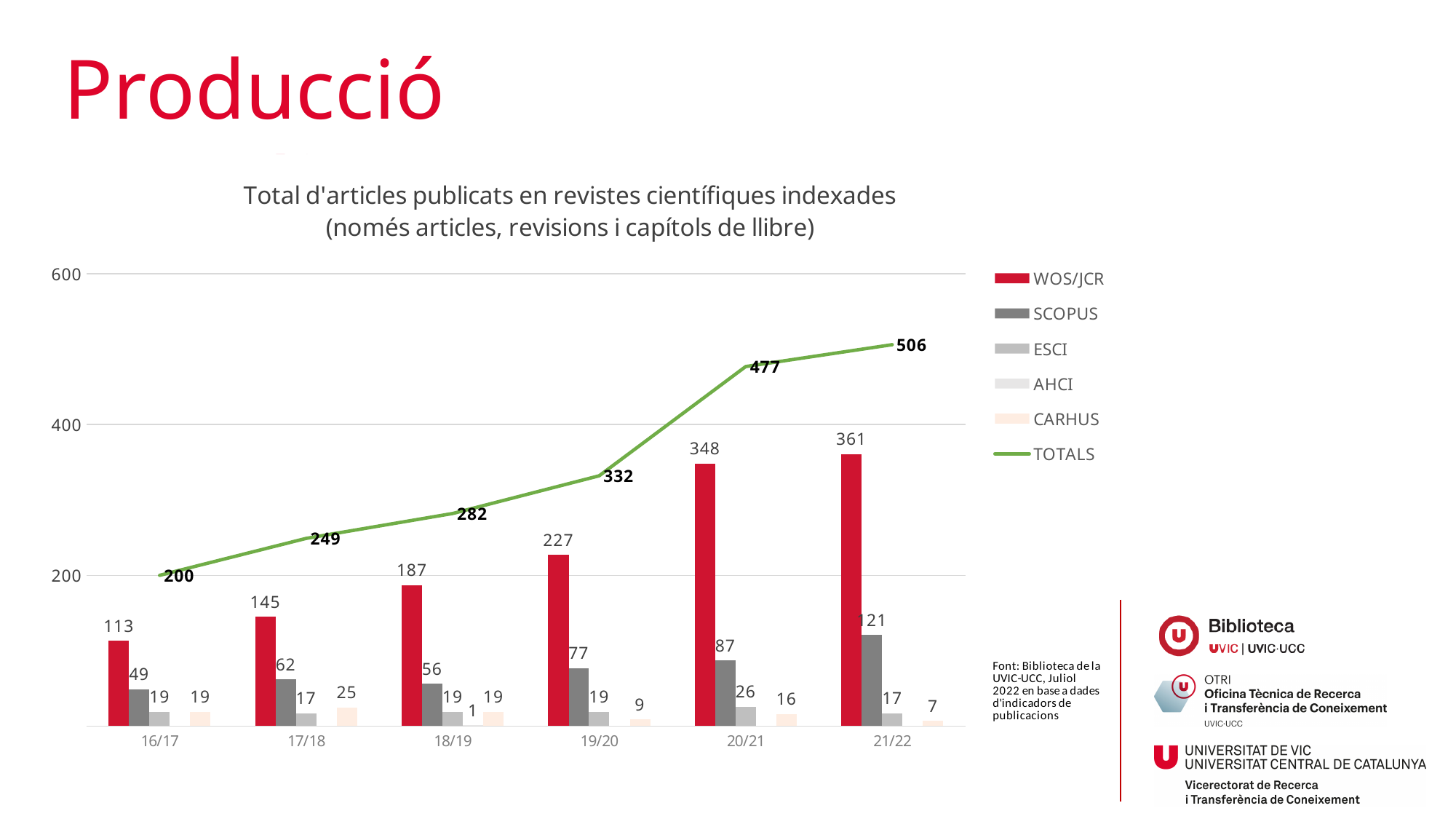
What is the SCOPUS value for 17/18? 62 By how much did the TOTALS value increase from 19/20 to 20/21? 145 What is the WOS/JCR value for 20/21? 348 Which is larger in 17/18: the CARHUS value or the ESCI value? CARHUS In which academic year is the CARHUS value lowest? 21/22 Does the TOTALS line rise or fall from 16/17 to 21/22? rise What is the difference between the WOS/JCR values for 21/22 and 20/21? 13 In which academic year is the WOS/JCR value highest? 21/22 What is the TOTALS value for 21/22? 506 Is the TOTALS value for 20/21 greater or less than 400? greater How many series does the legend list? 6 How many academic years are shown on the x axis? 6